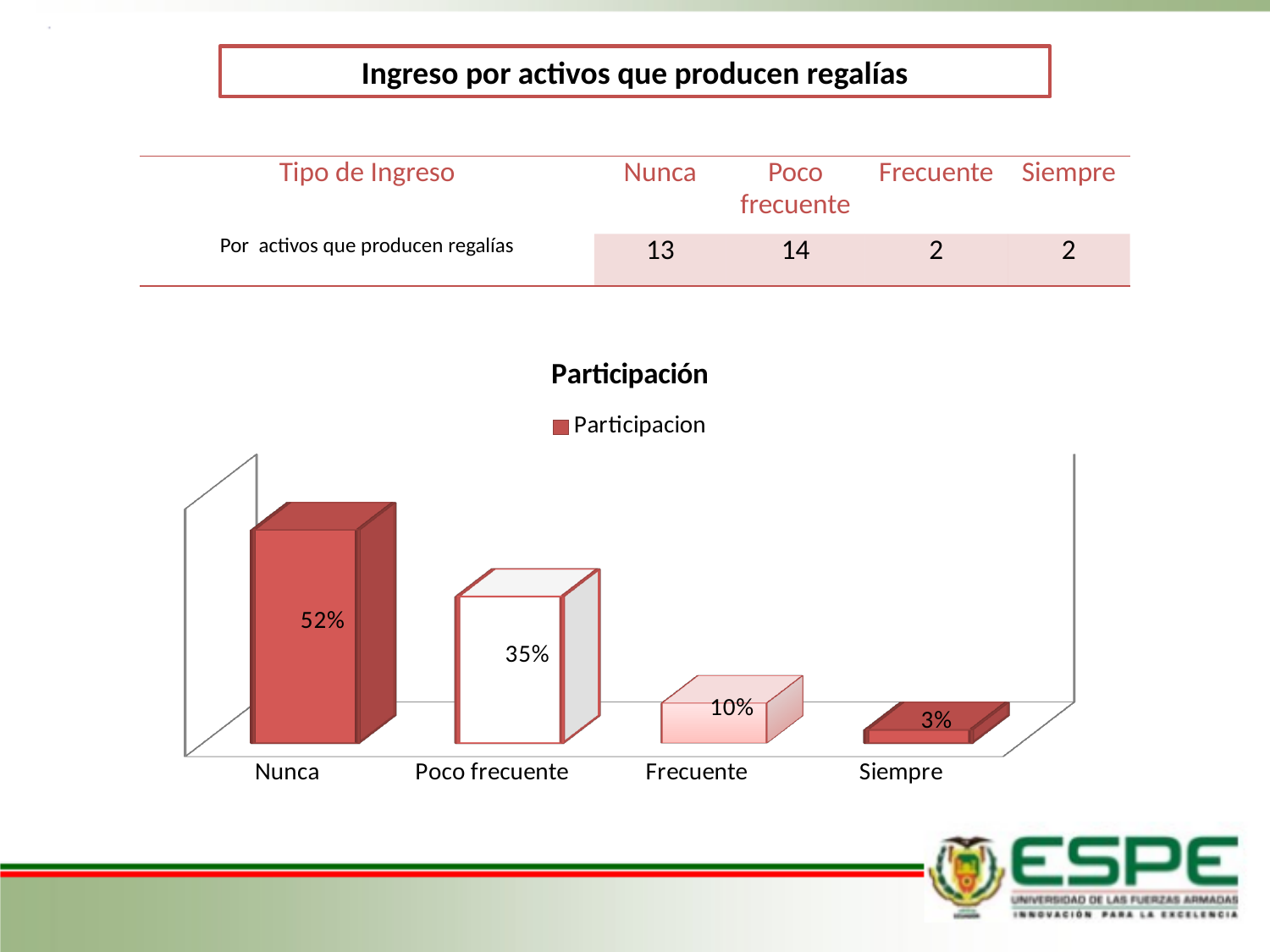
How many categories are shown in the Participación chart? 4 What kind of chart is the Participación chart? Bar chart Which category has the highest value in the Participación chart? Nunca What is the value for Nunca in the Participación chart? 52% What is the difference between the values for Nunca and Poco frecuente in the Participación chart? 17% Which is larger in the Participación chart, Frecuente or Siempre? Frecuente What is the value for Siempre in the Participación chart? 3% Do the values rise or fall from left to right along the x axis in the Participación chart? Fall Which category has the lowest value in the Participación chart? Siempre What is the value for Frecuente in the Participación chart? 10% How many series does the legend of the Participación chart list? 1 What is the value for Poco frecuente in the Participación chart? 35%